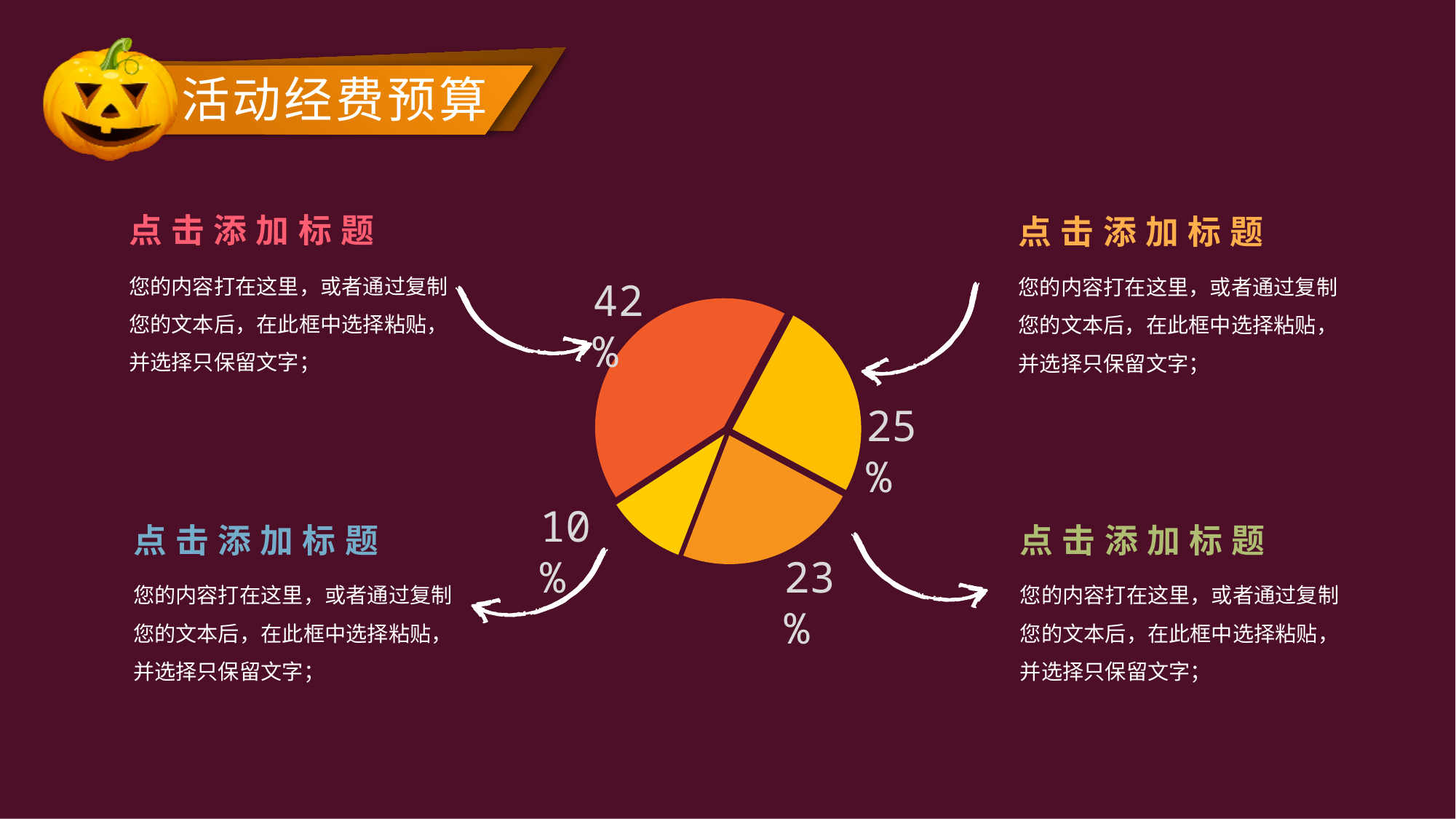
What is the smallest value labelled on the pie chart? 10% What is the largest value labelled on the pie chart? 42% What is the difference between the largest slice (42%) and the smallest slice (10%) of the pie chart? 32% What percentage is labelled on the red-orange slice on the left of the pie chart? 42% What is the title of the slide containing the pie chart? 活动经费预算 What kind of chart is shown on the slide? pie chart What percentage is labelled on the orange slice at the bottom right of the pie chart? 23% How many slices does the pie chart have? 4 What is the difference between the 25% slice and the 23% slice of the pie chart? 2% What is the combined share of the two slices labelled 25% and 23% on the pie chart? 48% Is the value of the largest slice of the pie chart greater or less than 40%? greater Which slice of the pie chart is larger, the red-orange slice labelled 42% or the yellow slice labelled 25%? the red-orange slice (42%)